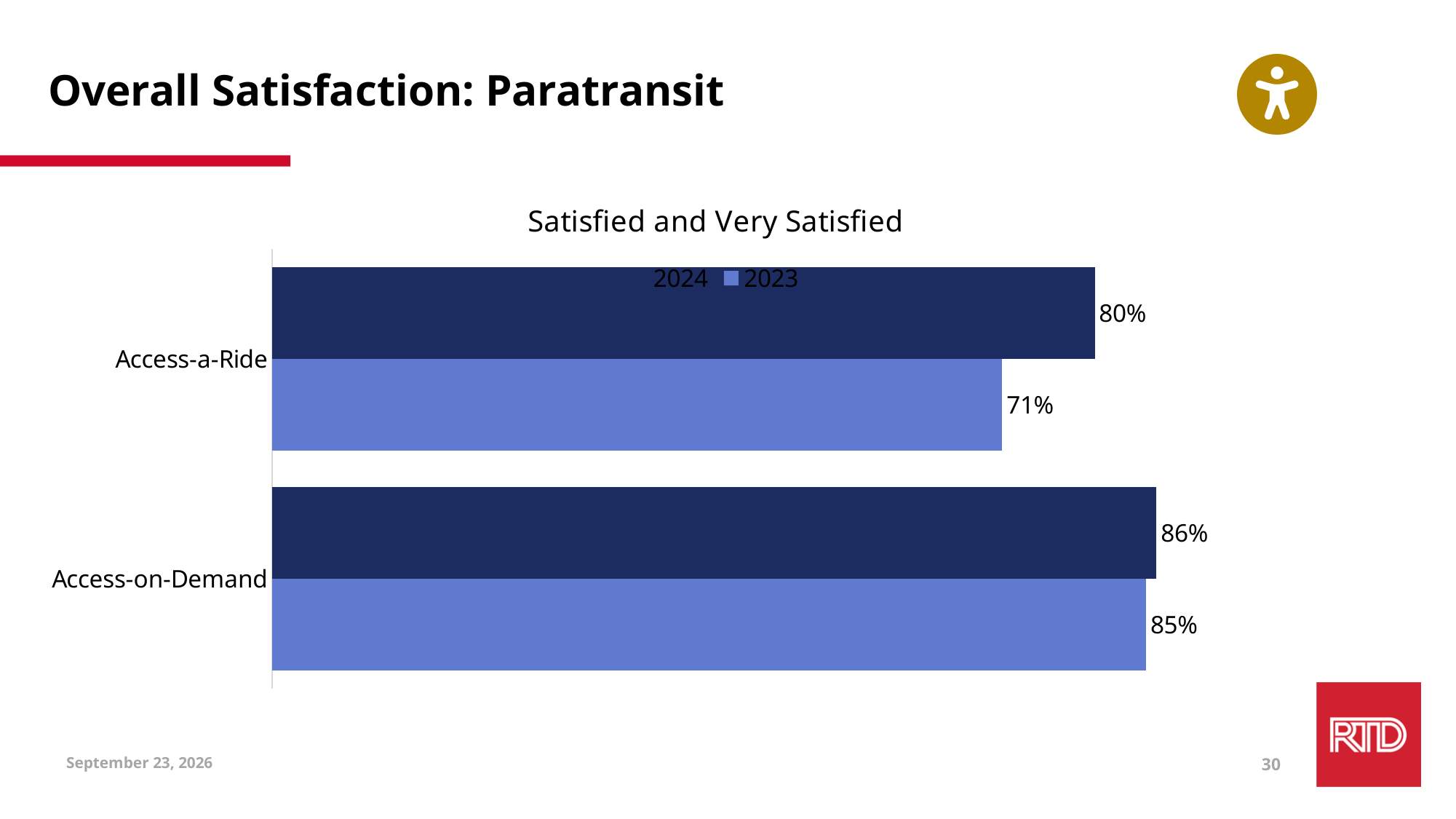
Which is larger: the 2023 value for Access-on-Demand or the 2023 value for Access-a-Ride? Access-on-Demand What is the difference between the 2024 and 2023 values for Access-a-Ride? 9% What is the 2023 value for Access-on-Demand? 85% What kind of chart is shown on the slide? Bar chart How many series does the legend list? 2 Which category has the lowest 2023 value? Access-a-Ride What is the difference between the 2024 values for Access-on-Demand and Access-a-Ride? 6% What is the 2024 value for Access-on-Demand? 86% What is the 2023 value for Access-a-Ride? 71% Which category has the highest 2024 value? Access-on-Demand What is the 2024 value for Access-a-Ride? 80% How many categories are shown on the chart? 2